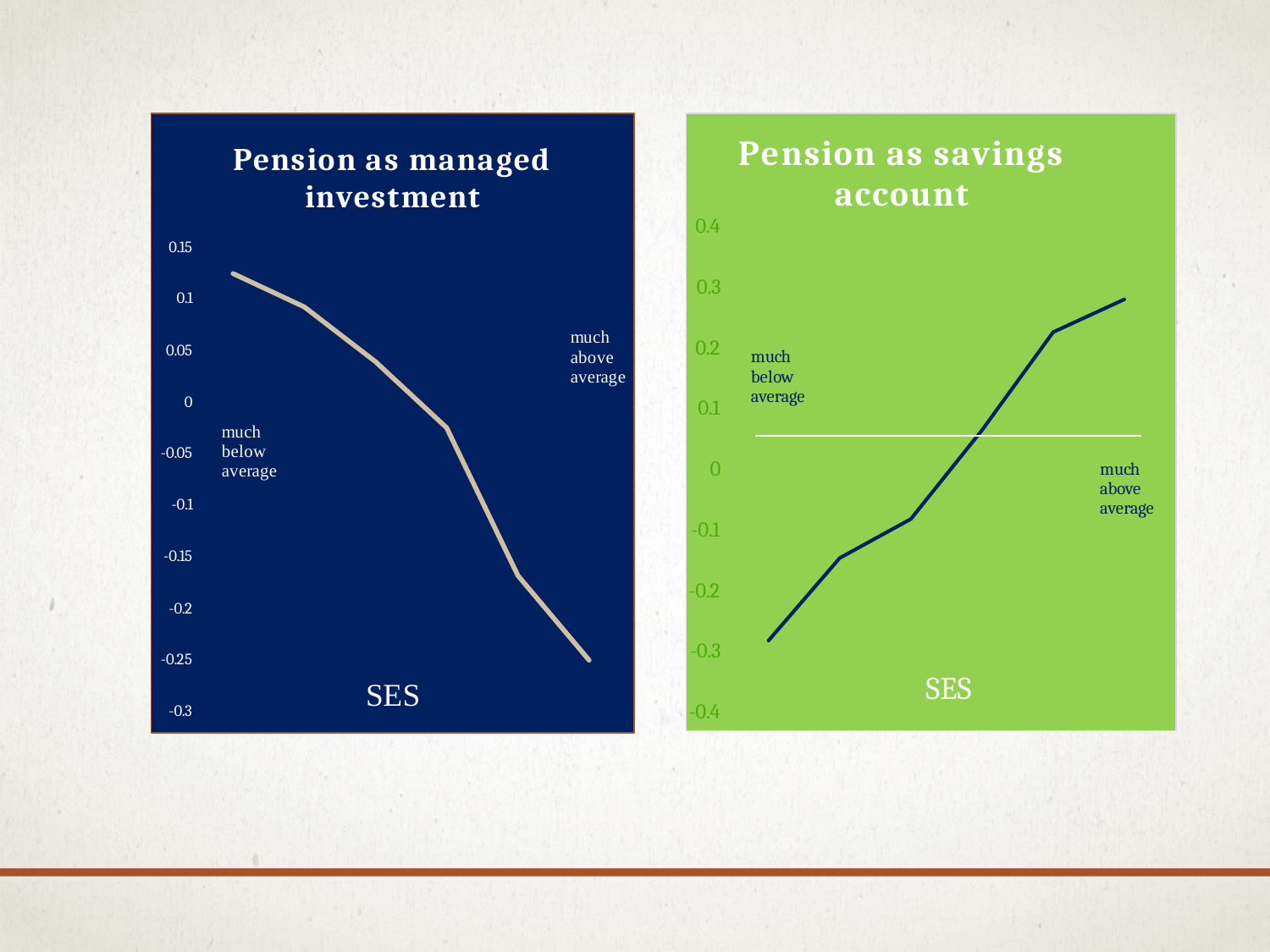
In the "Pension as managed investment" chart, is the value at the much below average end greater or less than 0.1? greater In the "Pension as savings account" chart, do the values rise or fall as SES increases from much below average to much above average? rise In the "Pension as savings account" chart, is the value at the much below average end greater or less than -0.2? less In the "Pension as managed investment" chart, is the value at the much above average end greater or less than -0.2? less In the "Pension as managed investment" chart, which end of the SES scale has the higher value, much below average or much above average? much below average What is the x-axis label on the "Pension as savings account" chart? SES In the "Pension as savings account" chart, which end of the SES scale has the higher value, much below average or much above average? much above average What is the title of the chart on the left side of the slide? Pension as managed investment In the "Pension as managed investment" chart, do the values rise or fall as SES increases from much below average to much above average? fall What kind of chart is the "Pension as managed investment" chart? line chart What kind of chart is the "Pension as savings account" chart? line chart